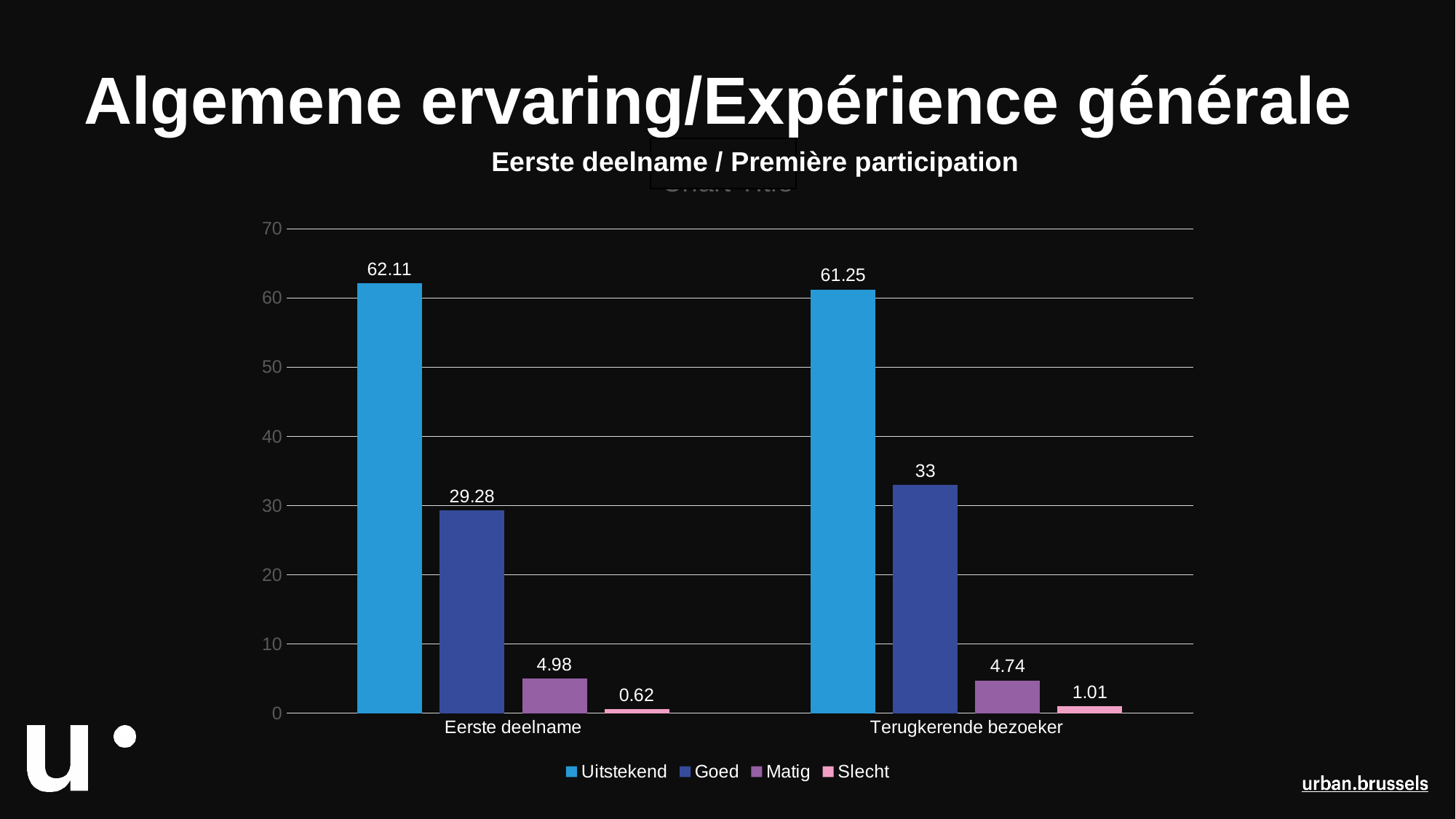
Which series has the highest value in the Terugkerende bezoeker category? Uitstekend Which legend entry is shown in light blue? Uitstekend How many series does the legend list? 4 Which is larger: the Matig value for Eerste deelname or for Terugkerende bezoeker? Eerste deelname What is the value for Goed in the Terugkerende bezoeker category? 33 What is the value for Matig in the Terugkerende bezoeker category? 4.74 What kind of chart is shown on the slide? Bar chart Which series has the lowest value in the Eerste deelname category? Slecht What is the value for Slecht in the Eerste deelname category? 0.62 What is the value for Uitstekend in the Eerste deelname category? 62.11 What is the difference between the Goed values for Terugkerende bezoeker and Eerste deelname? 3.72 How many categories are shown on the x axis? 2